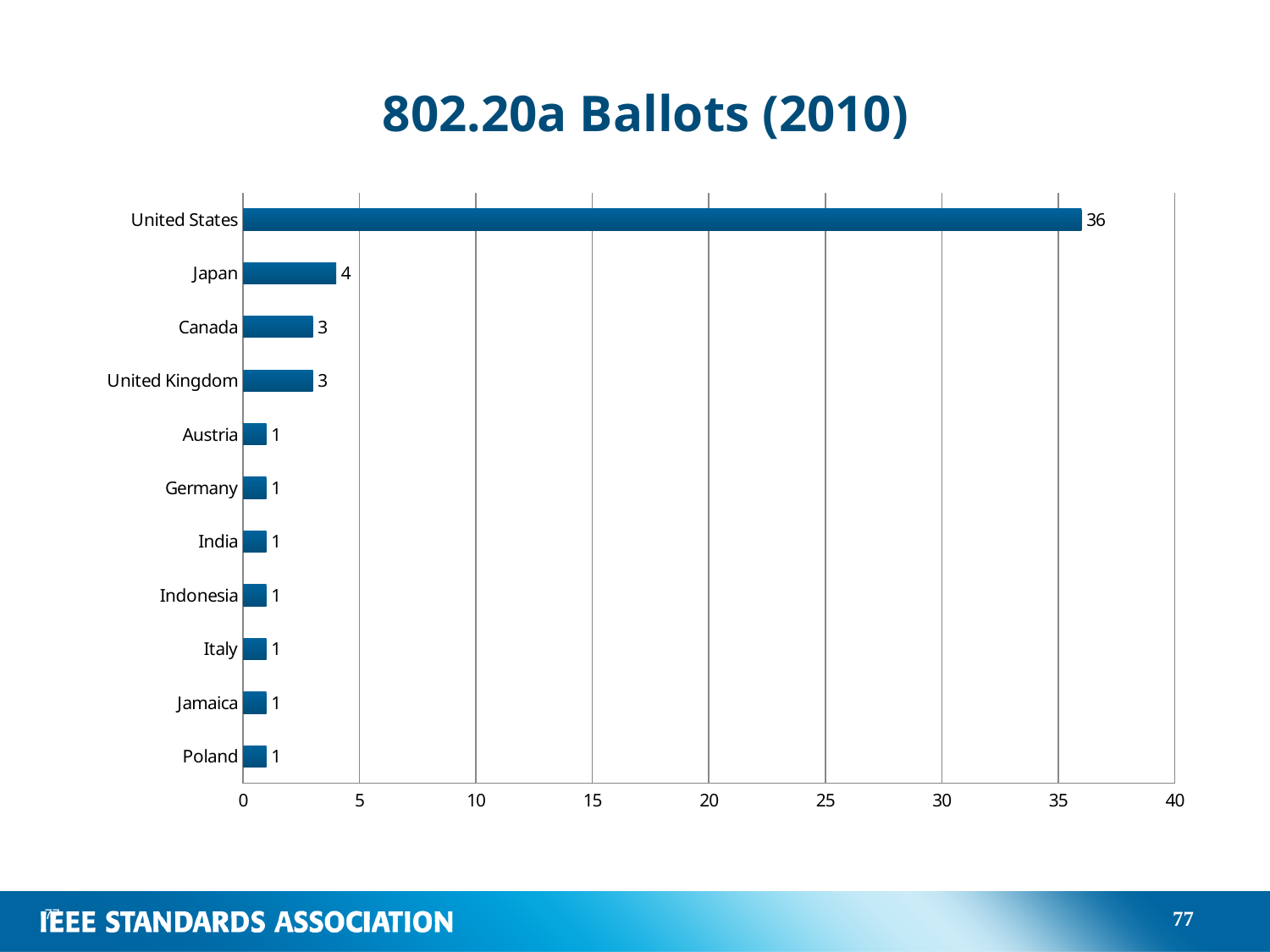
What is the difference between the values for Japan and United Kingdom? 1 What kind of chart is shown on the slide? bar chart What is the value for Japan? 4 What is the value for United States? 36 What is the title of the chart? 802.20a Ballots (2010) Which country has the highest value? United States What is the difference between the values for United States and Japan? 32 What is the value for Indonesia? 1 Which is larger, the value for Japan or the value for Canada? Japan Is the value for United States greater or less than 35? greater What is the value for Canada? 3 How many countries are shown in the chart? 11